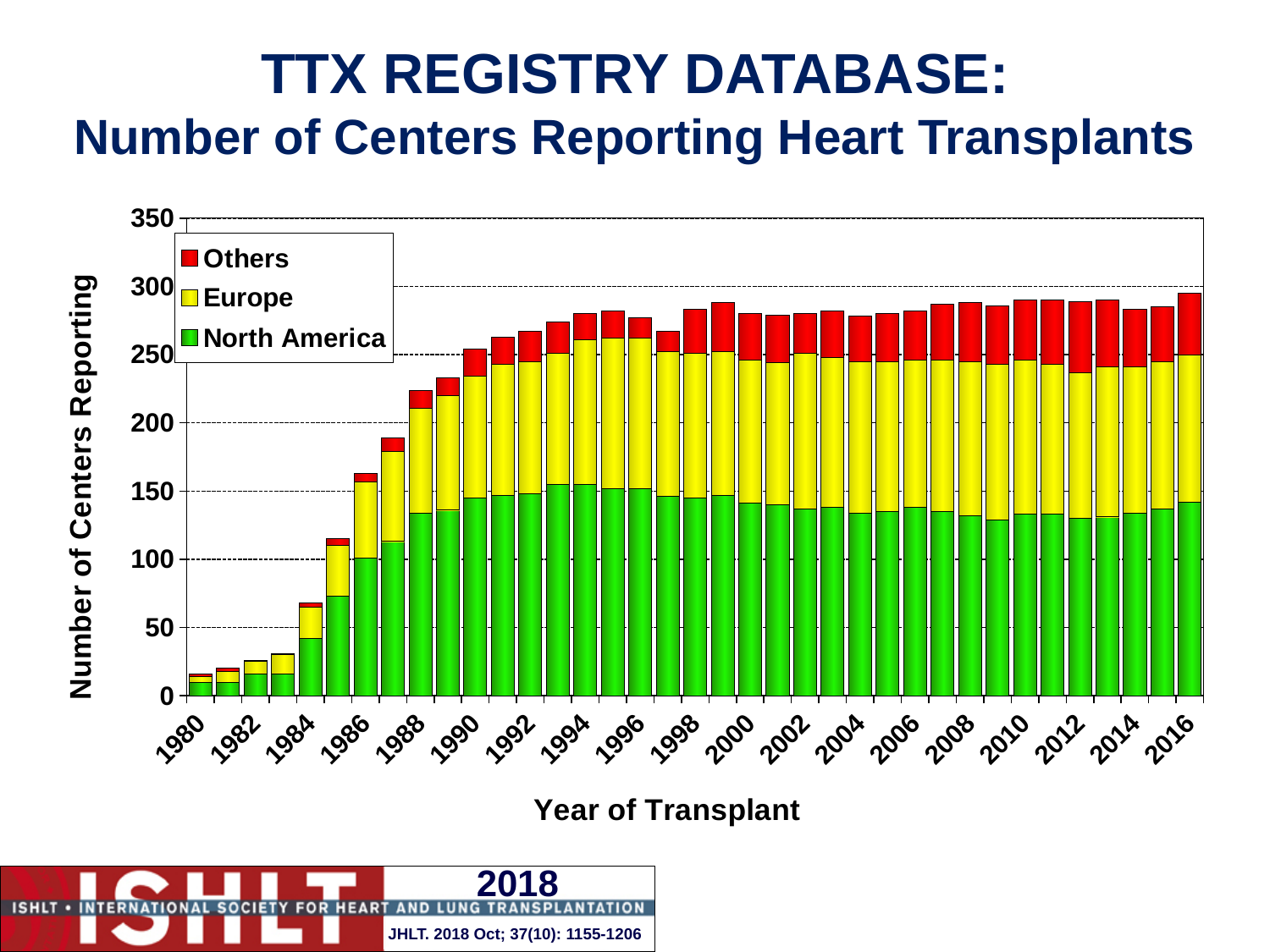
How many series does the legend list? 3 Which year has the lowest total number of centers reporting? 1980 Is the total number of centers reporting in 2016 greater or less than 250? greater How many years (bars) are plotted on the chart? 37 Which series are listed in the legend? Others, Europe, North America Do the total numbers of centers reporting rise or fall from 1980 to 1990? Rise What kind of chart is shown on the slide? Stacked bar chart Is the total number of centers reporting in 1984 greater or less than 50? greater What is the label of the y axis? Number of Centers Reporting Is the total number of centers reporting in 1980 greater or less than 50? less Which year has a larger total number of centers reporting, 1982 or 2000? 2000